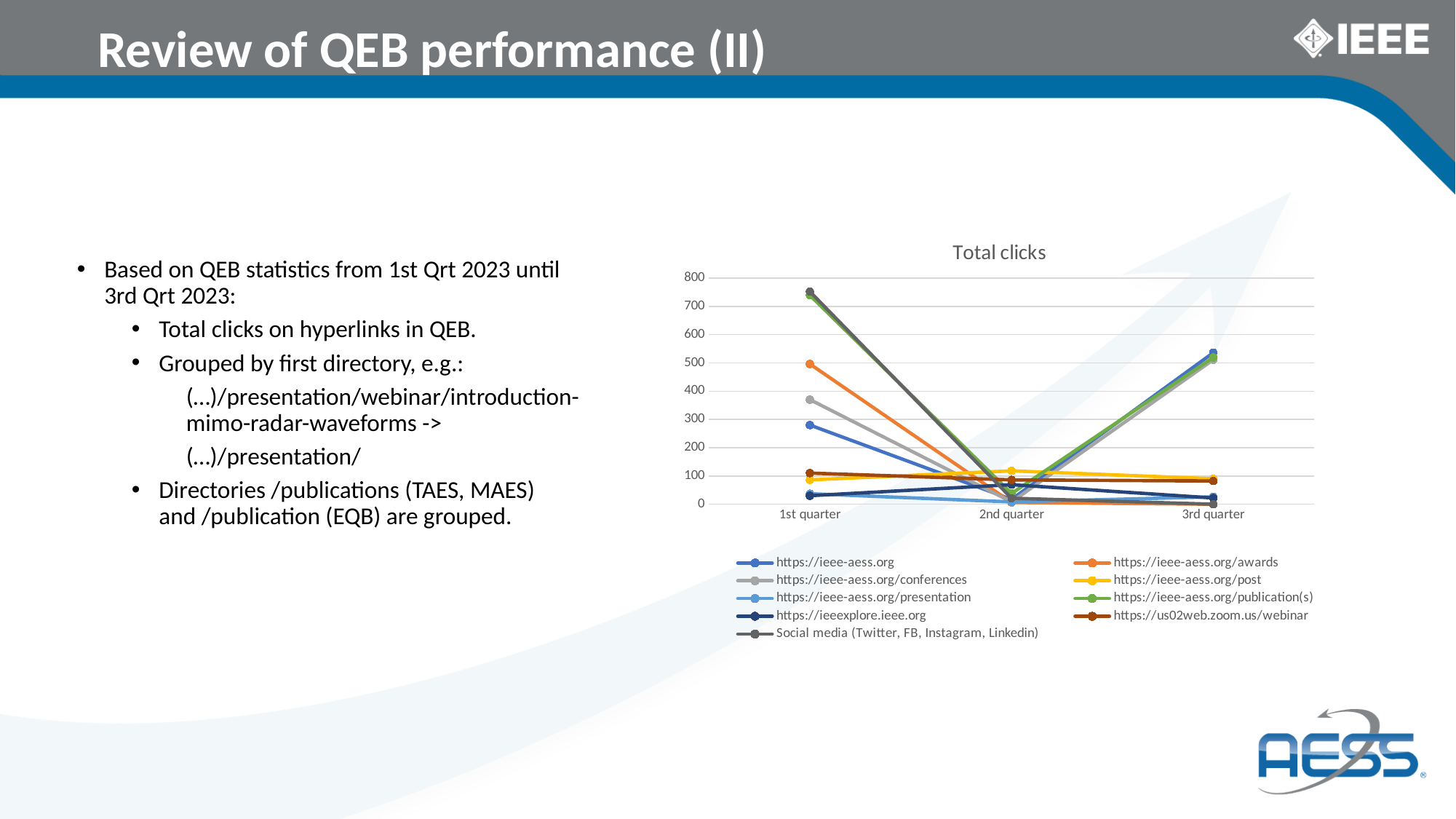
Does the value for https://ieee-aess.org/awards rise or fall from the 1st quarter to the 2nd quarter? fall Is the value for https://ieee-aess.org/conferences in the 1st quarter greater or less than 300? greater Is the value for https://ieee-aess.org/awards in the 1st quarter greater or less than 400? greater What kind of chart is shown on the slide? line chart How many quarters are shown on the x axis of the chart? 3 Is the value for https://ieee-aess.org in the 1st quarter greater or less than 200? greater In the 2nd quarter, which is larger: https://ieee-aess.org/post or https://ieee-aess.org/awards? https://ieee-aess.org/post What is the title of the chart? Total clicks How many series does the chart legend list? 9 Does the value for https://ieee-aess.org rise or fall from the 2nd quarter to the 3rd quarter? rise